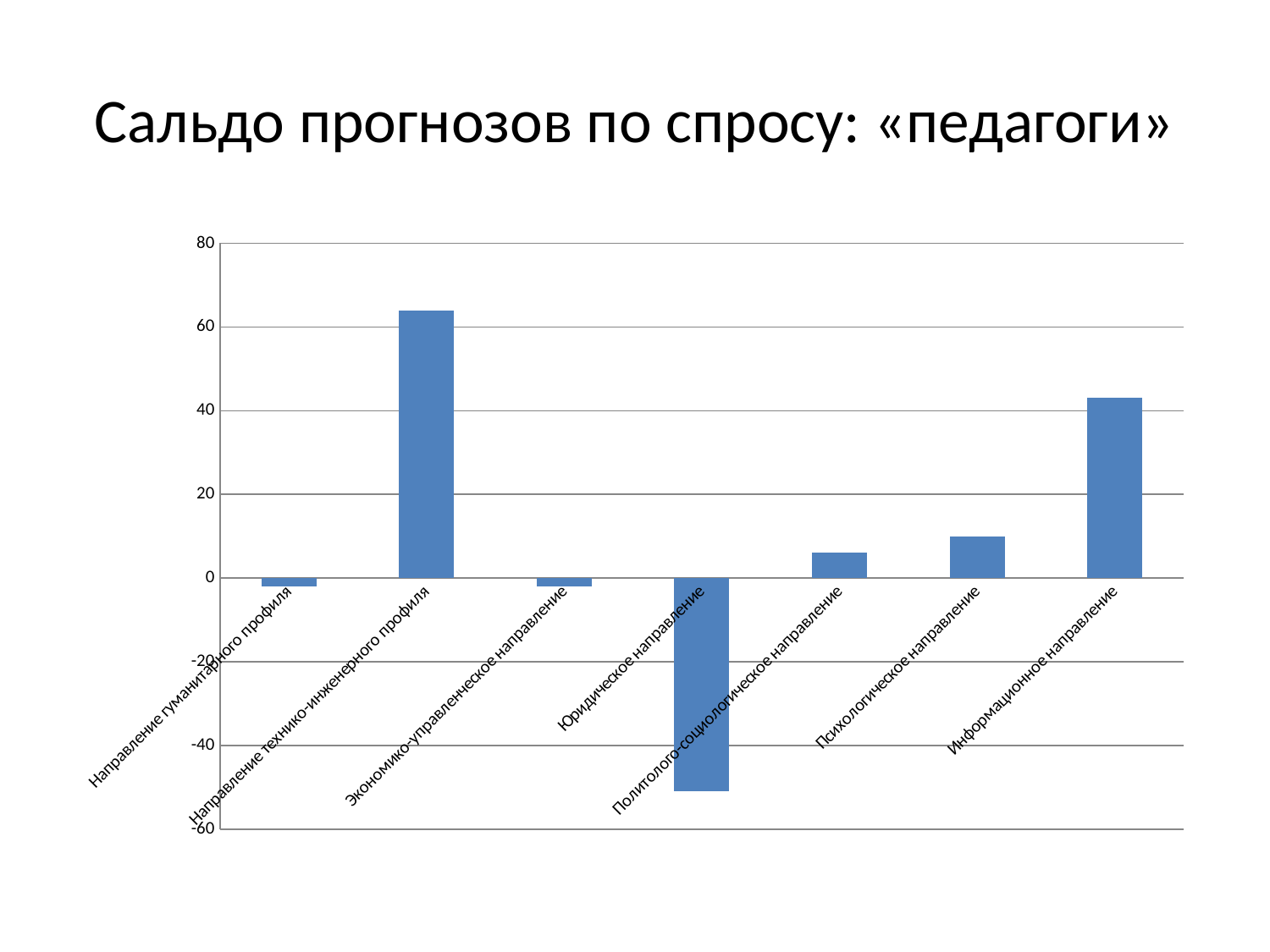
What is the title of the slide? Сальдо прогнозов по спросу: «педагоги» Which category has the highest value on the chart? Направление технико-инженерного профиля What kind of chart is shown on the slide? Bar chart Is the value for Психологическое направление greater or less than 20? less Is the value for Политолого-социологическое направление greater or less than 0? greater Is the value for Информационное направление greater or less than 20? greater How many categories are plotted on the chart? 7 Which category has the lowest value on the chart? Юридическое направление Which is larger, the value for Информационное направление or the value for Психологическое направление? Информационное направление Which is larger, the value for Направление технико-инженерного профиля or the value for Информационное направление? Направление технико-инженерного профиля